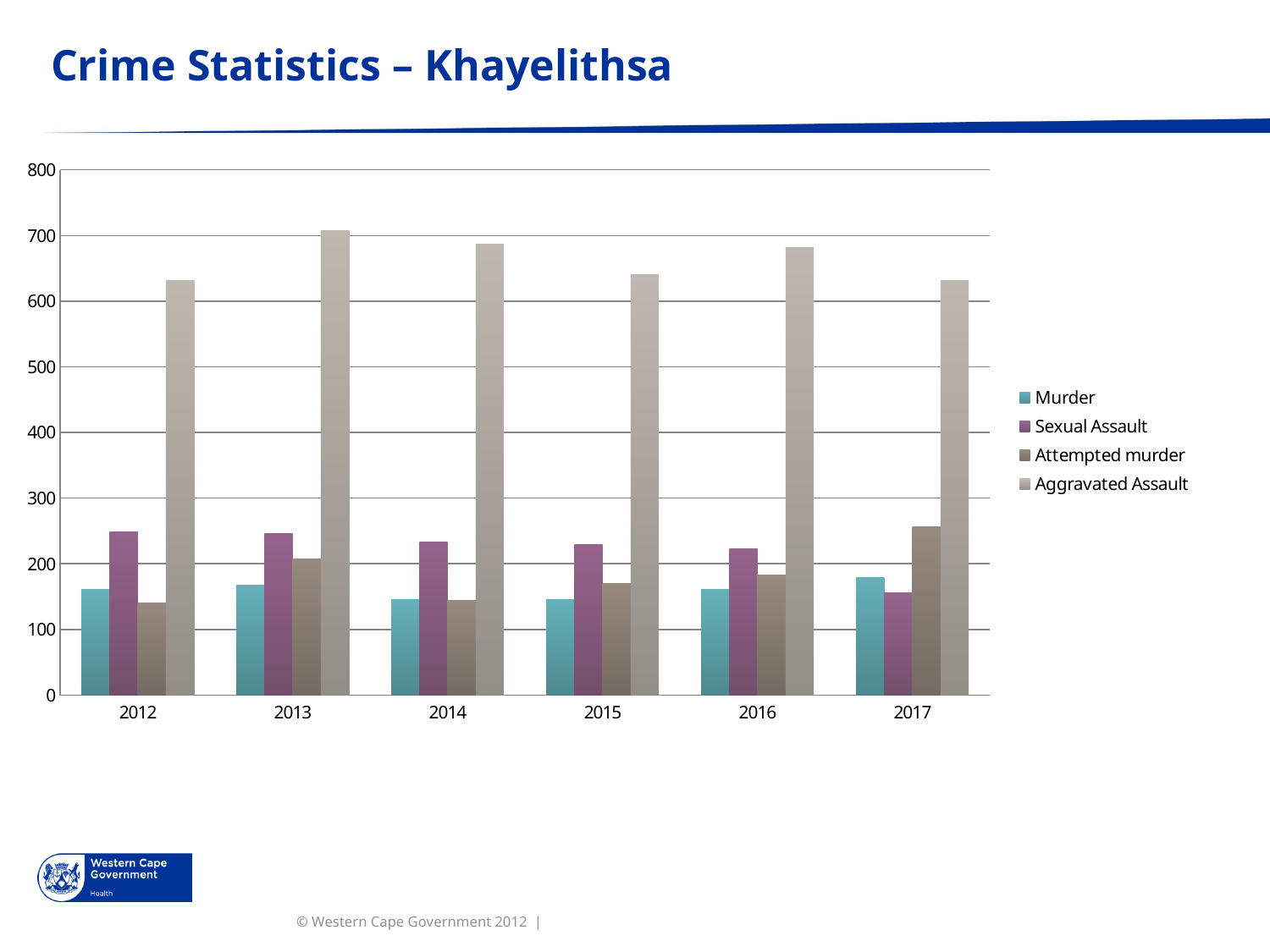
How many series does the legend list? 4 Is the value for Attempted murder in 2017 greater or less than 200? greater Does the Sexual Assault series rise or fall from 2012 to 2017? Fall Is the value for Aggravated Assault in 2012 greater or less than 700? less In which year is the Aggravated Assault bar highest? 2013 What is the title of the slide containing the chart? Crime Statistics – Khayelithsa In which year is the Murder bar highest? 2017 What kind of chart is shown on the slide? Bar chart Is the value for Murder in 2014 greater or less than 200? less In which year is the Sexual Assault bar lowest? 2017 How many years are shown on the x axis? 6 In 2017, which is larger: Attempted murder or Sexual Assault? Attempted murder